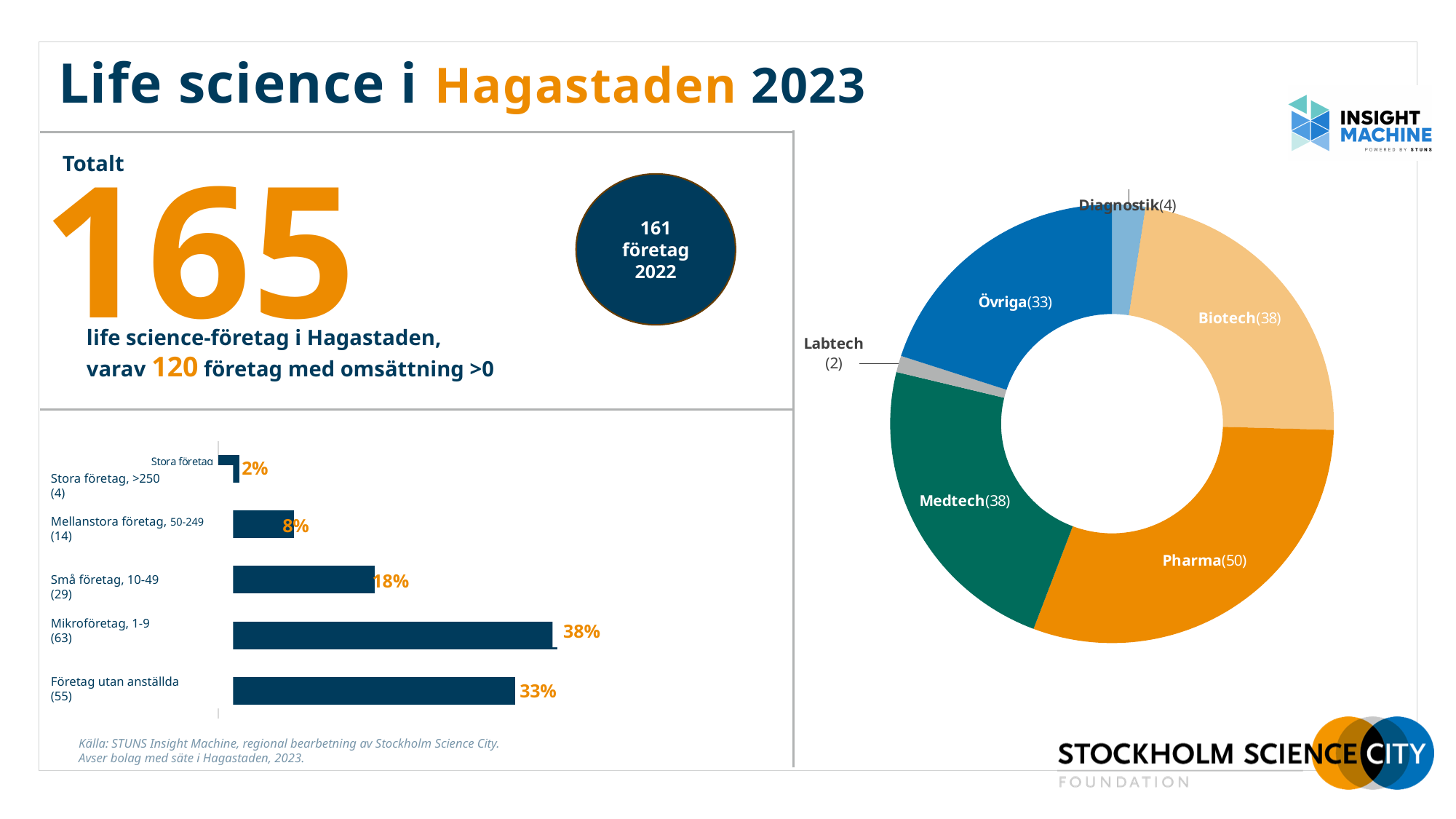
In the donut chart on the right, how many companies are in Pharma? 50 In the bar chart on the left, what is the difference in percentage points between Mikroföretag, 1-9 and Företag utan anställda? 5 What kind of chart is shown on the left side of the slide below the total? Bar chart In the donut chart on the right, what is the difference between the number of Pharma companies and Övriga companies? 17 In the bar chart on the left, which category has the highest percentage? Mikroföretag, 1-9 How many sectors does the donut chart on the right show? 6 How many categories does the bar chart on the left show? 5 In the bar chart on the left, what percentage is shown for Mikroföretag, 1-9? 38% In the bar chart on the left, which category has the lowest percentage? Stora företag, >250 In the bar chart on the left, what percentage is shown for Små företag, 10-49? 18% In the donut chart on the right, which sector has the fewest companies? Labtech In the bar chart on the left, which is larger: Mellanstora företag, 50-249 or Små företag, 10-49? Små företag, 10-49